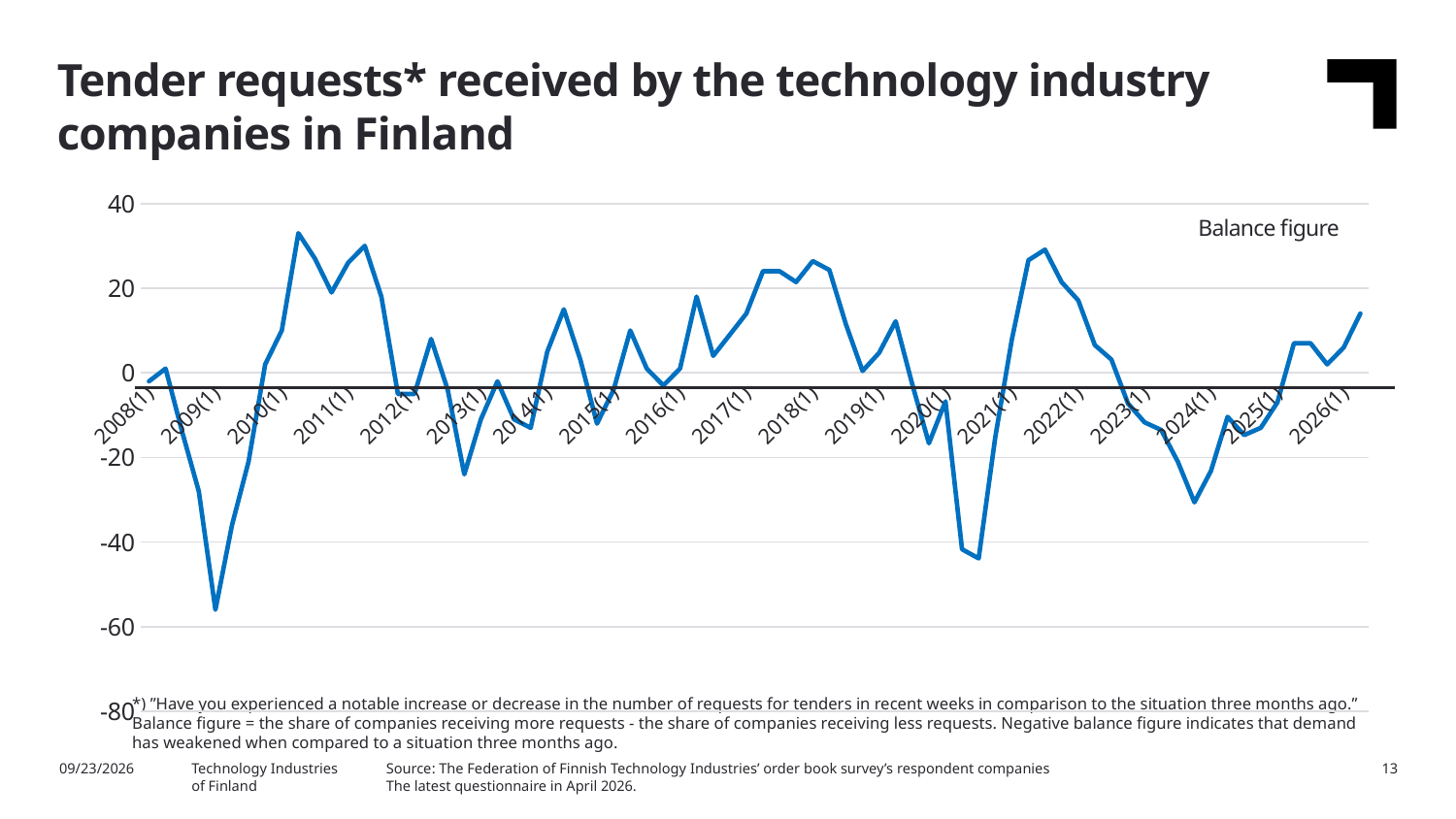
In which year does the balance figure reach its lowest point? 2009 What is the name of the series plotted in the chart? Balance figure What kind of chart is shown on the slide? line chart How many year labels are shown on the x axis of the chart? 19 Is the balance figure at 2022(1) greater or less than 20? less What is the title of the chart on the slide? Tender requests* received by the technology industry companies in Finland Which is larger, the balance figure at 2022(1) or at 2024(1)? 2022(1) Does the balance figure rise or fall between 2008(1) and 2009(1)? fall Is the balance figure at 2013(1) greater or less than 0? less Is the balance figure at 2026(1) greater or less than 0? greater Does the balance figure rise or fall between 2022(1) and 2024(1)? fall